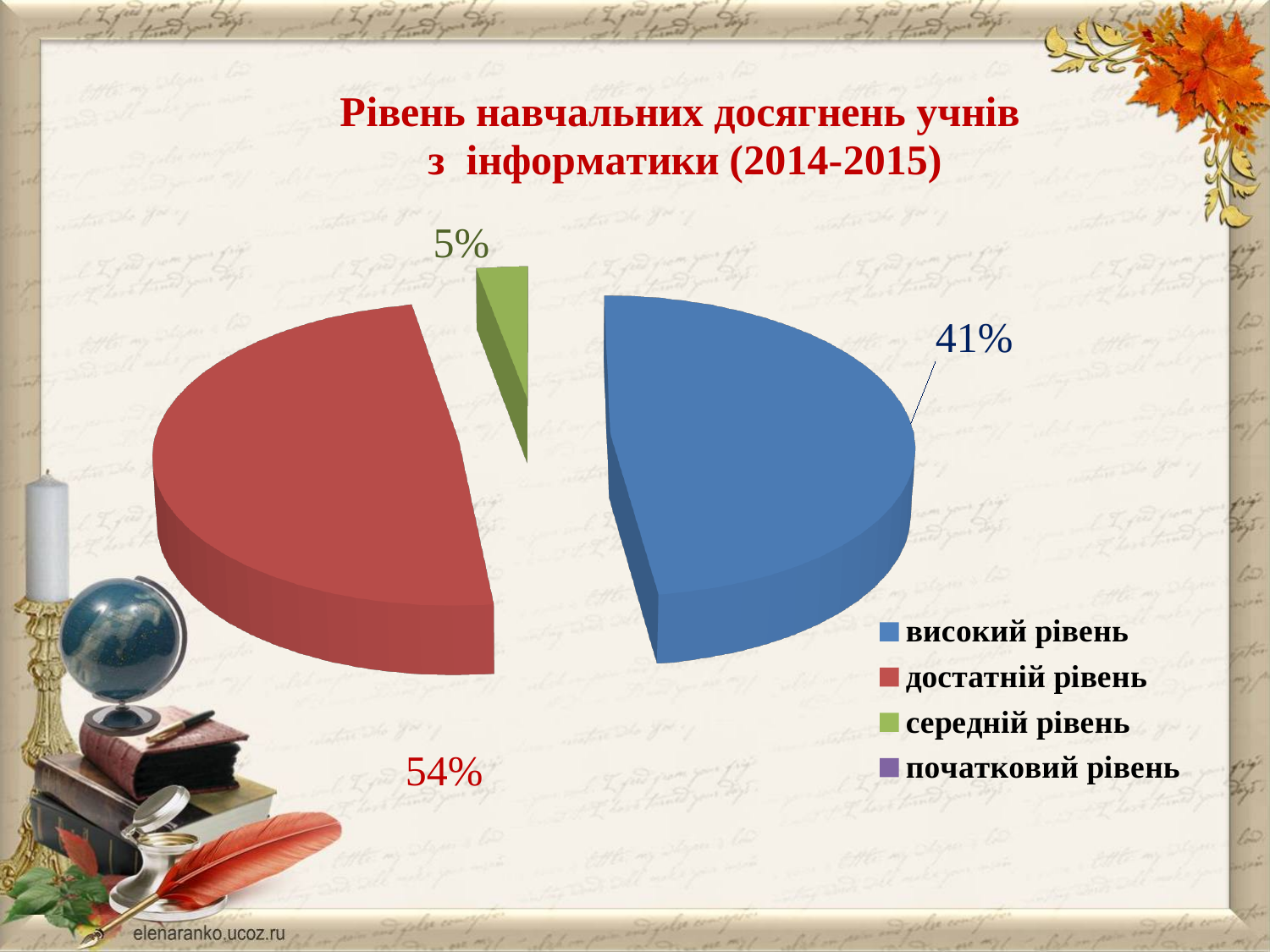
What percentage of students are at the "високий рівень" level? 41% Which is larger, the share for "високий рівень" or the share for "середній рівень"? високий рівень What percentage of students are at the "середній рівень" level? 5% What type of chart is shown on the slide? pie chart What colour is the slice for "високий рівень"? blue What percentage of students are at the "достатній рівень" level? 54% How many slices with data labels are visible in the pie? 3 What is the difference in percentage points between "достатній рівень" and "високий рівень"? 13 Which of the labelled slices is the smallest? середній рівень Which school years does the chart title refer to? 2014-2015 Which level has the largest share of the pie? достатній рівень How many entries does the legend list? 4